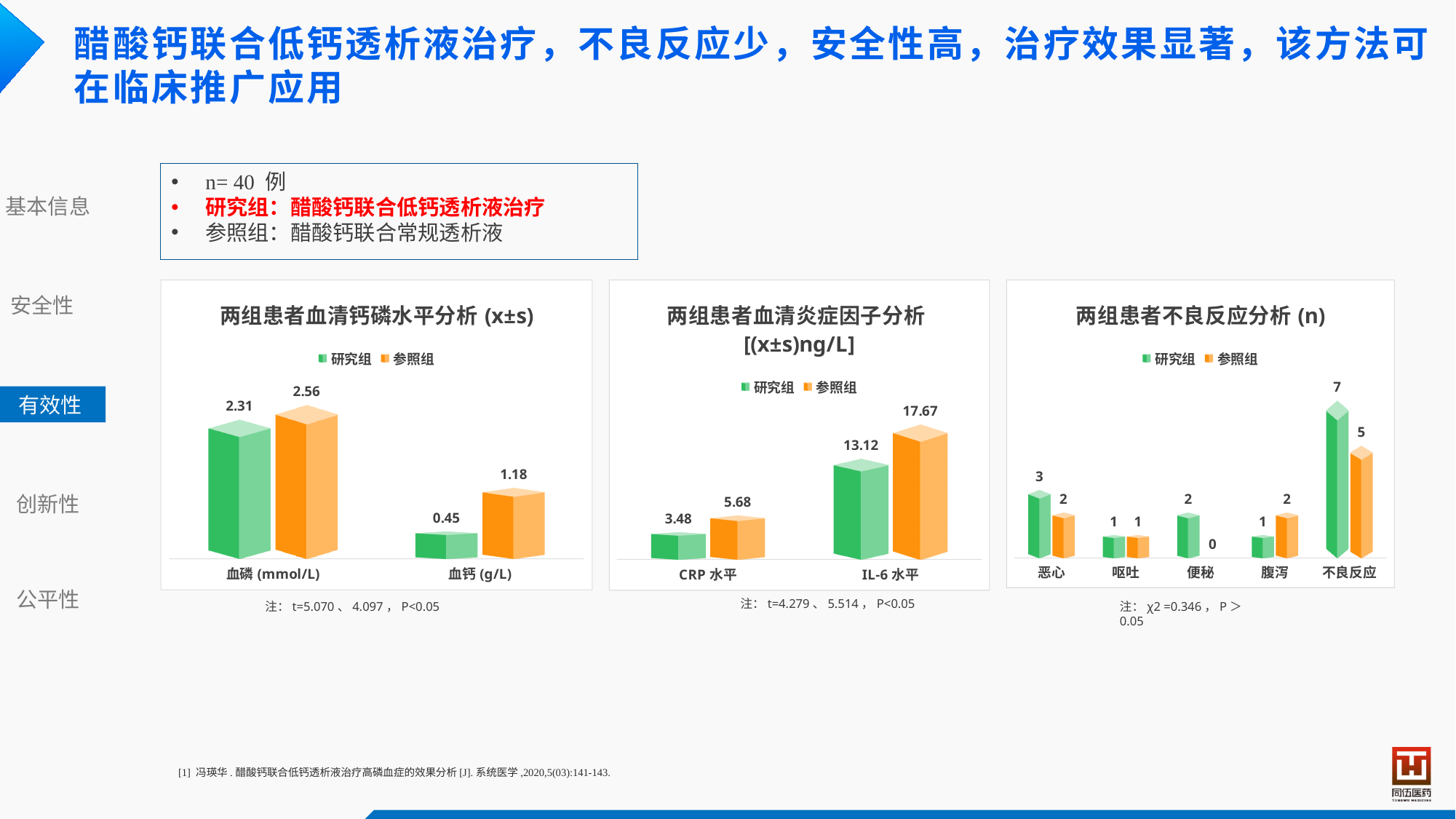
In the chart titled 两组患者不良反应分析 (n), what is the 便秘 value for 参照组? 0 In the chart titled 两组患者血清炎症因子分析 [(x±s)ng/L], what is the difference between the 参照组 and 研究组 values for IL-6 水平? 4.55 In the chart titled 两组患者血清炎症因子分析 [(x±s)ng/L], what is the IL-6 水平 value for 参照组? 17.67 What type of chart is the chart titled 两组患者不良反应分析 (n)? Bar chart In the chart titled 两组患者血清炎症因子分析 [(x±s)ng/L], which group has the higher CRP 水平 value? 参照组 In the chart titled 两组患者血清钙磷水平分析 (x±s), what is the difference between the 参照组 and 研究组 values for 血钙 (g/L)? 0.73 In the chart titled 两组患者血清钙磷水平分析 (x±s), what is the 血钙 (g/L) value for 参照组? 1.18 In the chart titled 两组患者血清钙磷水平分析 (x±s), what is the 血磷 (mmol/L) value for 研究组? 2.31 In the chart titled 两组患者血清炎症因子分析 [(x±s)ng/L], how many series does the legend list? 2 In the chart titled 两组患者不良反应分析 (n), how many categories are shown on the x axis? 5 In the chart titled 两组患者不良反应分析 (n), which category has the highest value for 研究组? 不良反应 In the chart titled 两组患者不良反应分析 (n), what is the difference between the 研究组 and 参照组 values for 不良反应? 2